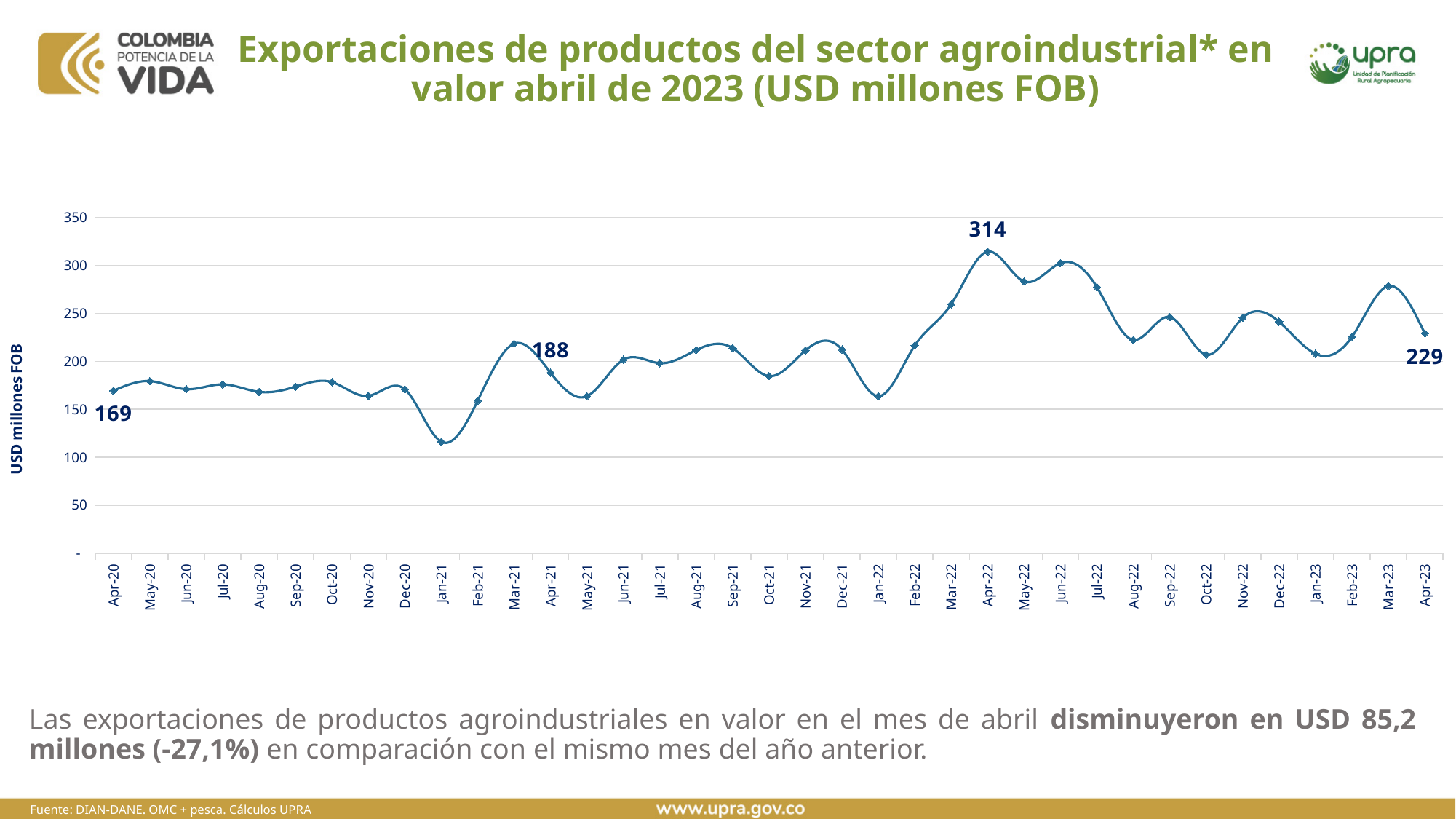
Which month has the highest value in the chart? Apr-22 Is the value for Mar-23 greater or less than 250? greater Which is larger, the value for Apr-21 or the value for Apr-20? Apr-21 What is the difference between the values for Apr-22 and Apr-23? 85 Which month has the lowest value in the chart? Jan-21 What is the label of the vertical axis? USD millones FOB What is the value for Apr-21? 188 What type of chart is shown on the slide? Line chart What is the value for Apr-20? 169 Is the value for Jan-21 greater or less than 150? less What is the value for Apr-23? 229 What is the value for Apr-22? 314